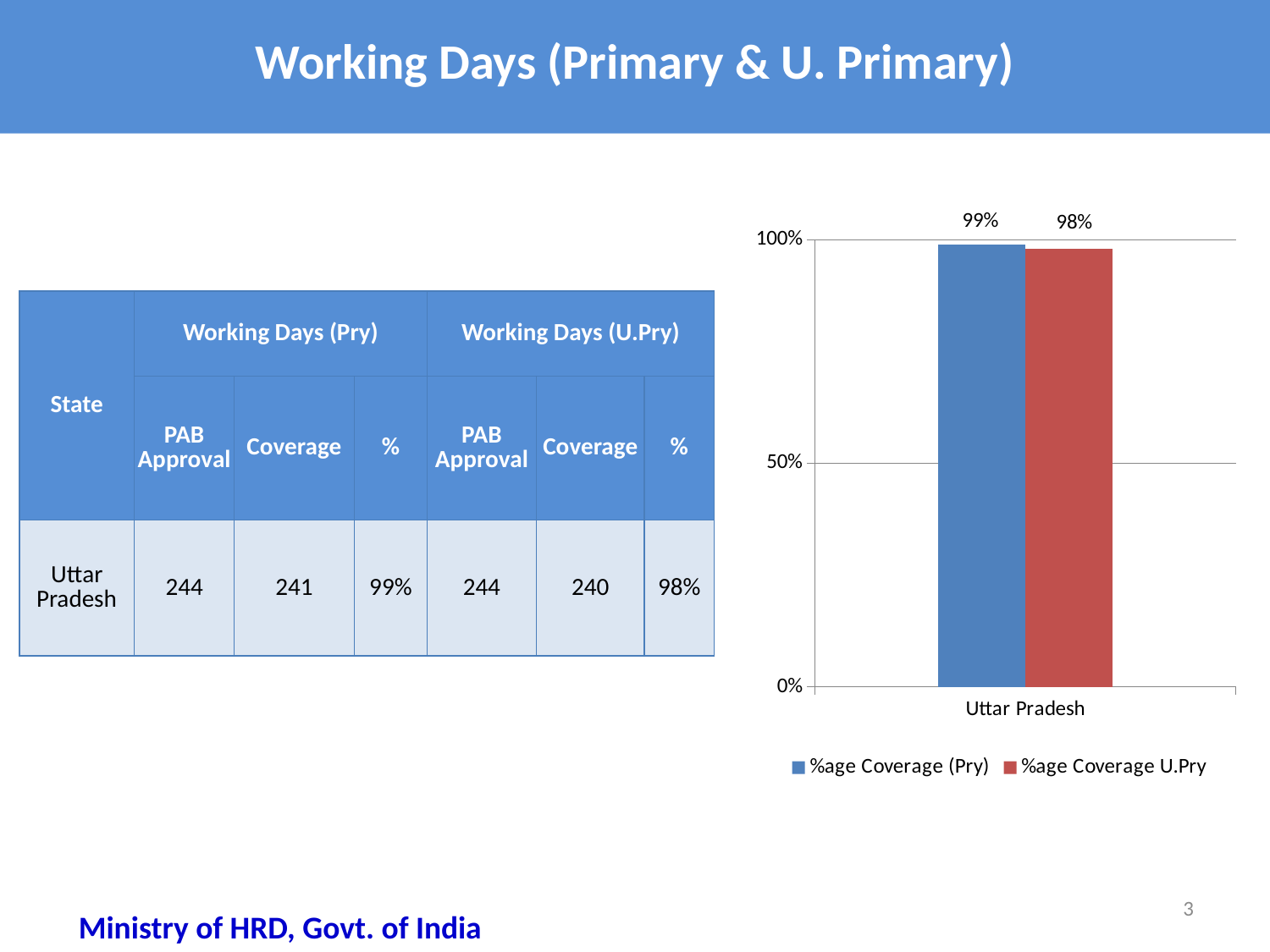
What is the value of %age Coverage U.Pry for Uttar Pradesh in the chart? 98% How many categories are shown on the x axis of the chart? 1 What kind of chart is shown on the slide? bar chart What colour is the %age Coverage U.Pry series in the chart? red Which series has the higher value for Uttar Pradesh, %age Coverage (Pry) or %age Coverage U.Pry? %age Coverage (Pry) What is the value of %age Coverage (Pry) for Uttar Pradesh in the chart? 99% What is the difference between %age Coverage (Pry) and %age Coverage U.Pry for Uttar Pradesh? 1% Which category is shown on the x axis of the chart? Uttar Pradesh Is the value for %age Coverage U.Pry for Uttar Pradesh greater or less than 50%? greater How many series does the chart legend list? 2